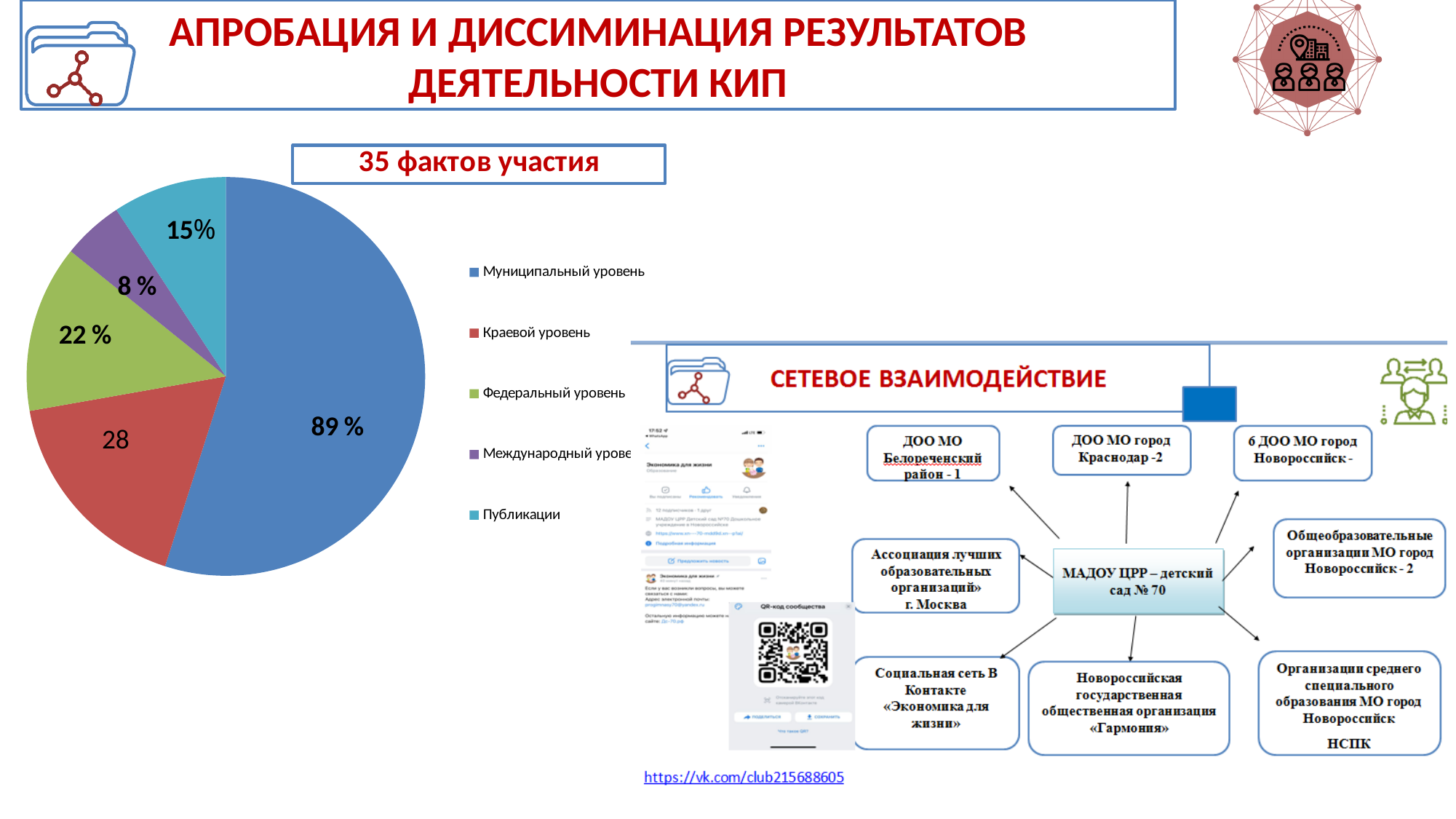
In the pie chart, what value is shown for Федеральный уровень? 22 % Which category has the smallest slice in the pie chart? Международный уровень What is the title shown above the pie chart? 35 фактов участия Which category has the largest slice in the pie chart? Муниципальный уровень In the pie chart, what value is shown for Краевой уровень? 28 How many entries does the pie chart legend list? 5 In the pie chart, what value is shown for Муниципальный уровень? 89 % In the pie chart, which slice is larger: Федеральный уровень or Публикации? Федеральный уровень In the pie chart, what value is shown for Международный уровень? 8 % In the pie chart, what value is shown for Публикации? 15% How many slices does the pie chart have? 5 What type of chart is shown on the left of the slide? pie chart